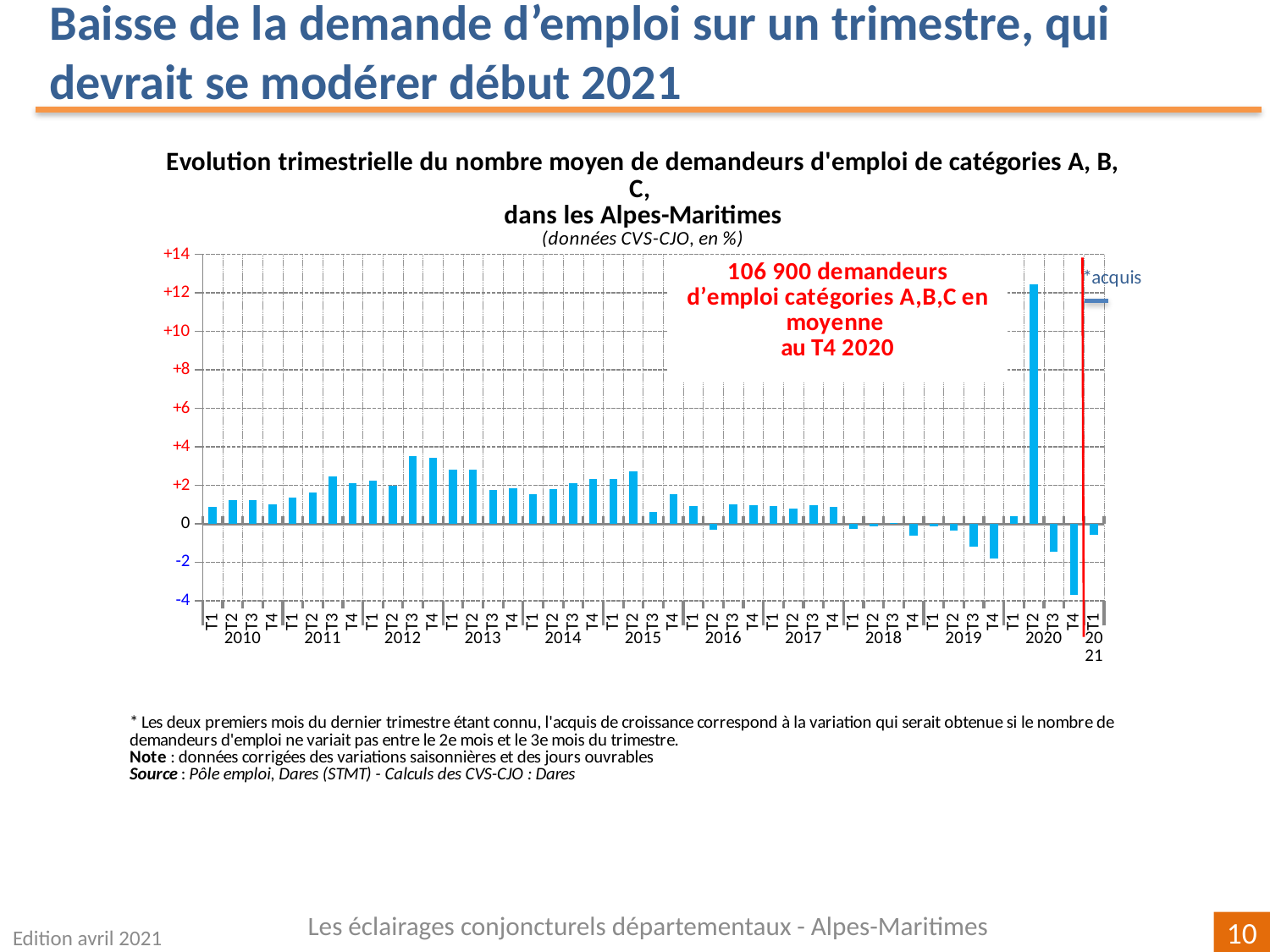
According to the annotation on the chart, how many job seekers in categories A, B, C were there on average in T4 2020? 106 900 Which quarter has the lowest value on the chart? T4 2020 Which quarter has the highest value on the chart? T2 2020 In what unit are the chart's data expressed, according to the subtitle? % Is the value for T4 2020 greater or less than -2? less Is the value for T3 2012 greater or less than +2? greater Which is larger, the value for T3 2012 or the value for T1 2010? T3 2012 Is the value for T2 2020 greater or less than +10? greater Between T3 2012 and T4 2018, do the bars generally rise or fall? fall How many years are labelled on the x axis of the chart? 12 What kind of chart is shown on the slide? bar chart